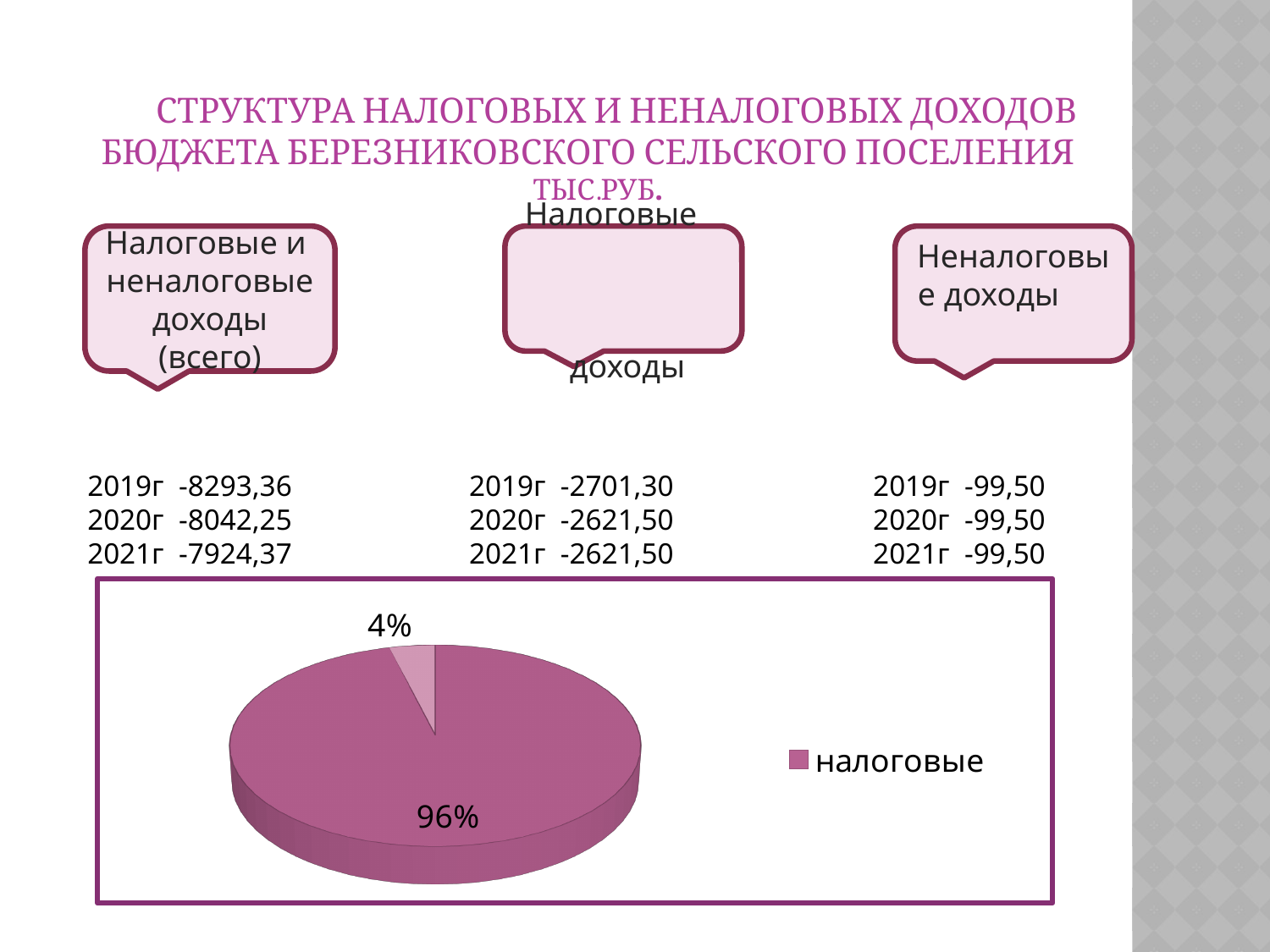
What percentage is shown on the smaller slice of the pie chart? 4% What is the name of the entry shown in the pie chart's legend? налоговые How many entries does the legend of the pie chart list? 1 Is the share of the налоговые slice greater or less than 50%? greater What kind of chart is shown on the slide? pie chart What share of the pie does the налоговые slice represent? 96% Which is larger: the налоговые slice or the other slice of the pie? налоговые Which slice of the pie chart is the largest? налоговые Is the smaller slice of the pie chart greater or less than 10%? less How many slices does the pie chart have? 2 What is the difference in percentage points between the 96% slice and the 4% slice? 92 percentage points